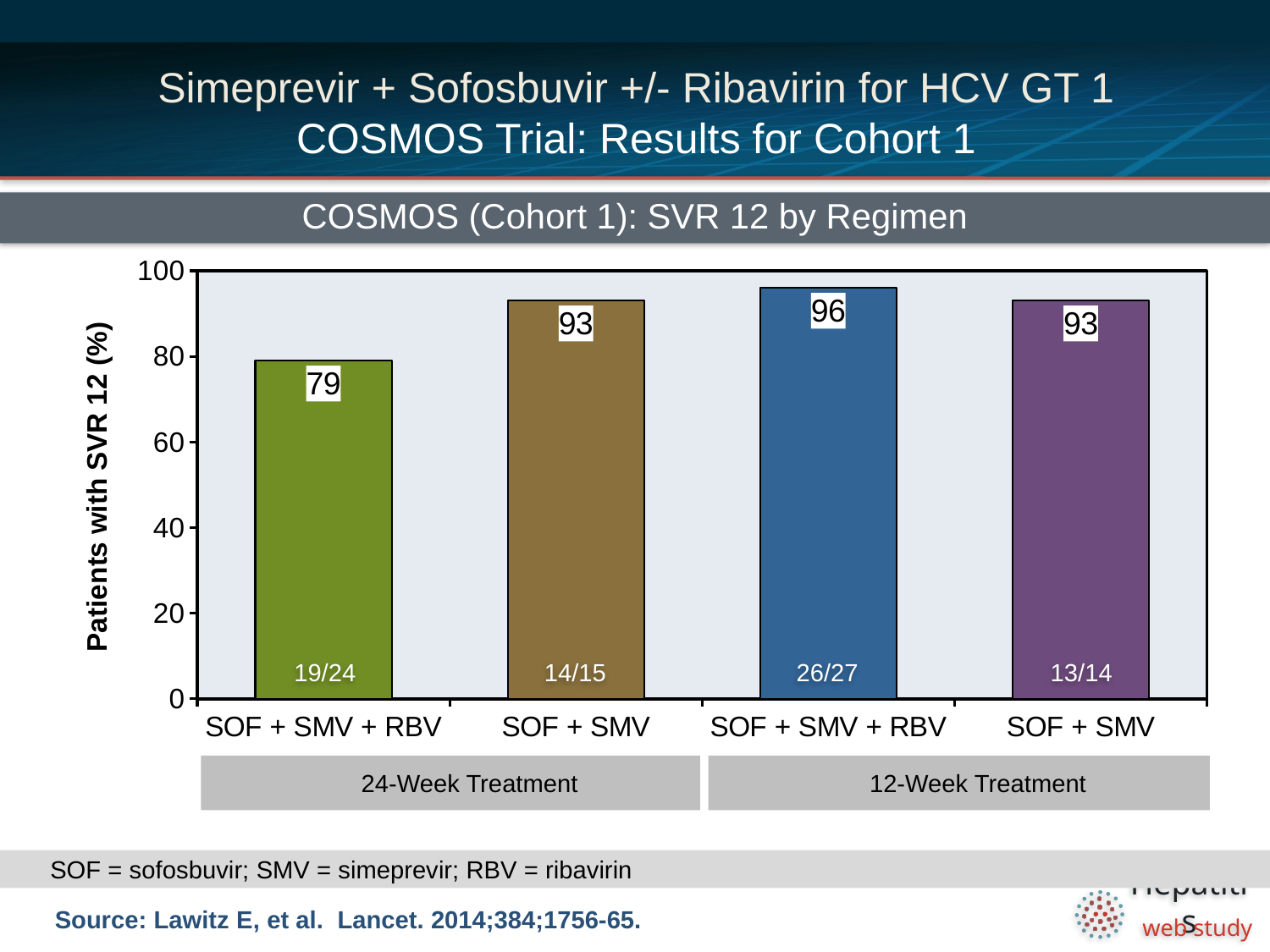
Which regimen and treatment duration has the highest SVR 12 rate? SOF + SMV + RBV, 12-Week Treatment What is the SVR 12 rate for SOF + SMV + RBV in the 12-Week Treatment group? 96 Which has a higher SVR 12 rate: SOF + SMV in the 24-Week group or SOF + SMV + RBV in the 24-Week group? SOF + SMV in the 24-Week group What is the label of the y-axis? Patients with SVR 12 (%) What fraction of patients is shown inside the bar for SOF + SMV + RBV in the 24-Week Treatment group? 19/24 What is the difference in SVR 12 rate between SOF + SMV + RBV in the 12-Week group and SOF + SMV + RBV in the 24-Week group? 17 What type of chart is shown on the slide? Bar chart What fraction of patients is shown inside the bar for SOF + SMV in the 12-Week Treatment group? 13/14 What is the SVR 12 rate for SOF + SMV in the 24-Week Treatment group? 93 What is the SVR 12 rate for SOF + SMV + RBV in the 24-Week Treatment group? 79 Which regimen and treatment duration has the lowest SVR 12 rate? SOF + SMV + RBV, 24-Week Treatment How many bars are plotted in the chart? 4